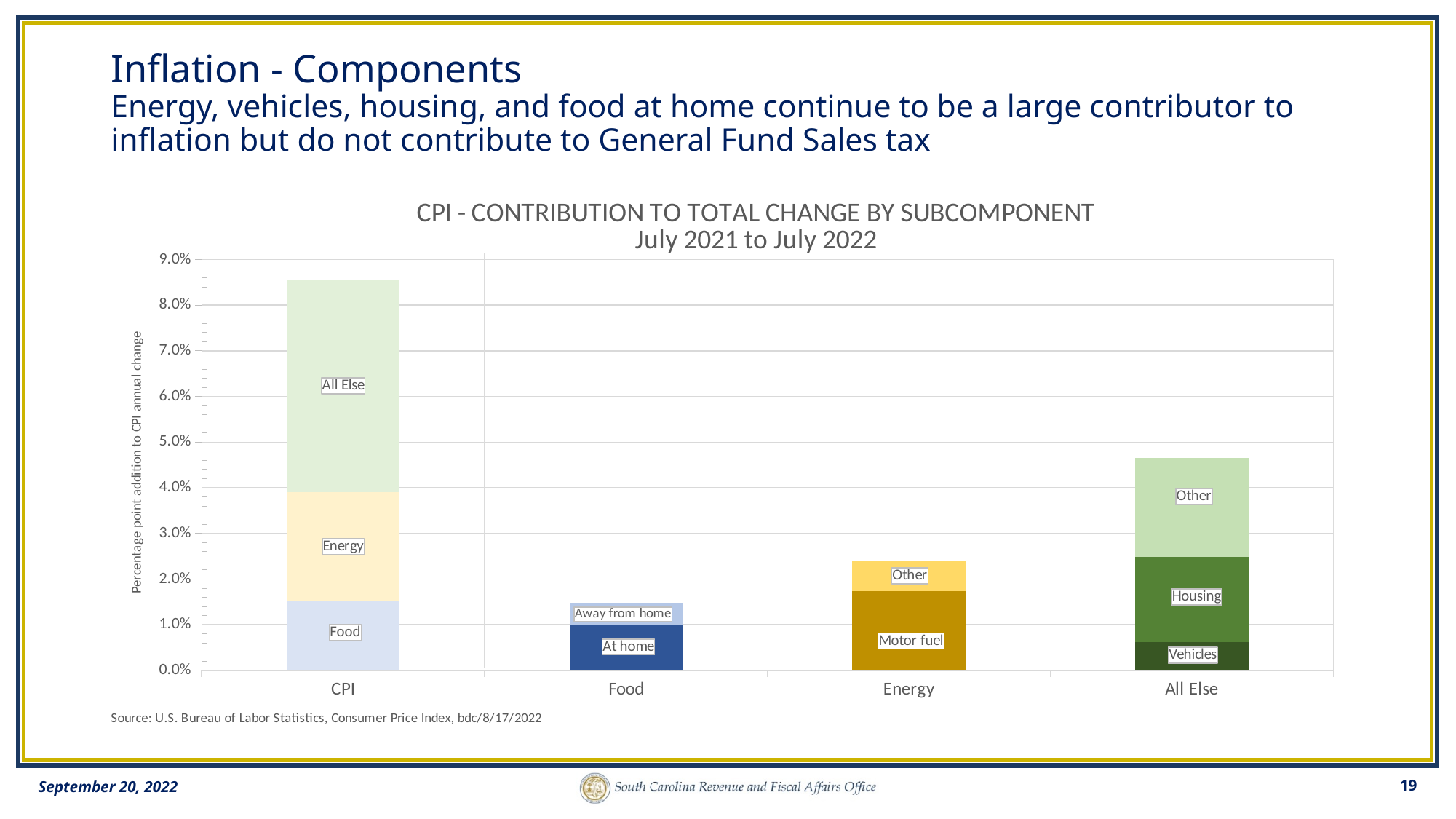
Is the total height of the Food bar greater or less than 2.0%? less Which bar is taller, All Else or Energy? All Else What is the title of the chart? CPI - CONTRIBUTION TO TOTAL CHANGE BY SUBCOMPONENT July 2021 to July 2022 Is the total height of the Energy bar greater or less than 3.0%? less Which category has the shortest bar in the chart? Food Is the total height of the CPI bar greater or less than 8.0%? greater What are the three segments labelled in the All Else bar? Vehicles, Housing, Other Which bar is taller, Energy or Food? Energy What kind of chart is shown on the slide? Bar chart How many categories are shown on the x axis of the chart? 4 Which category has the tallest bar in the chart? CPI